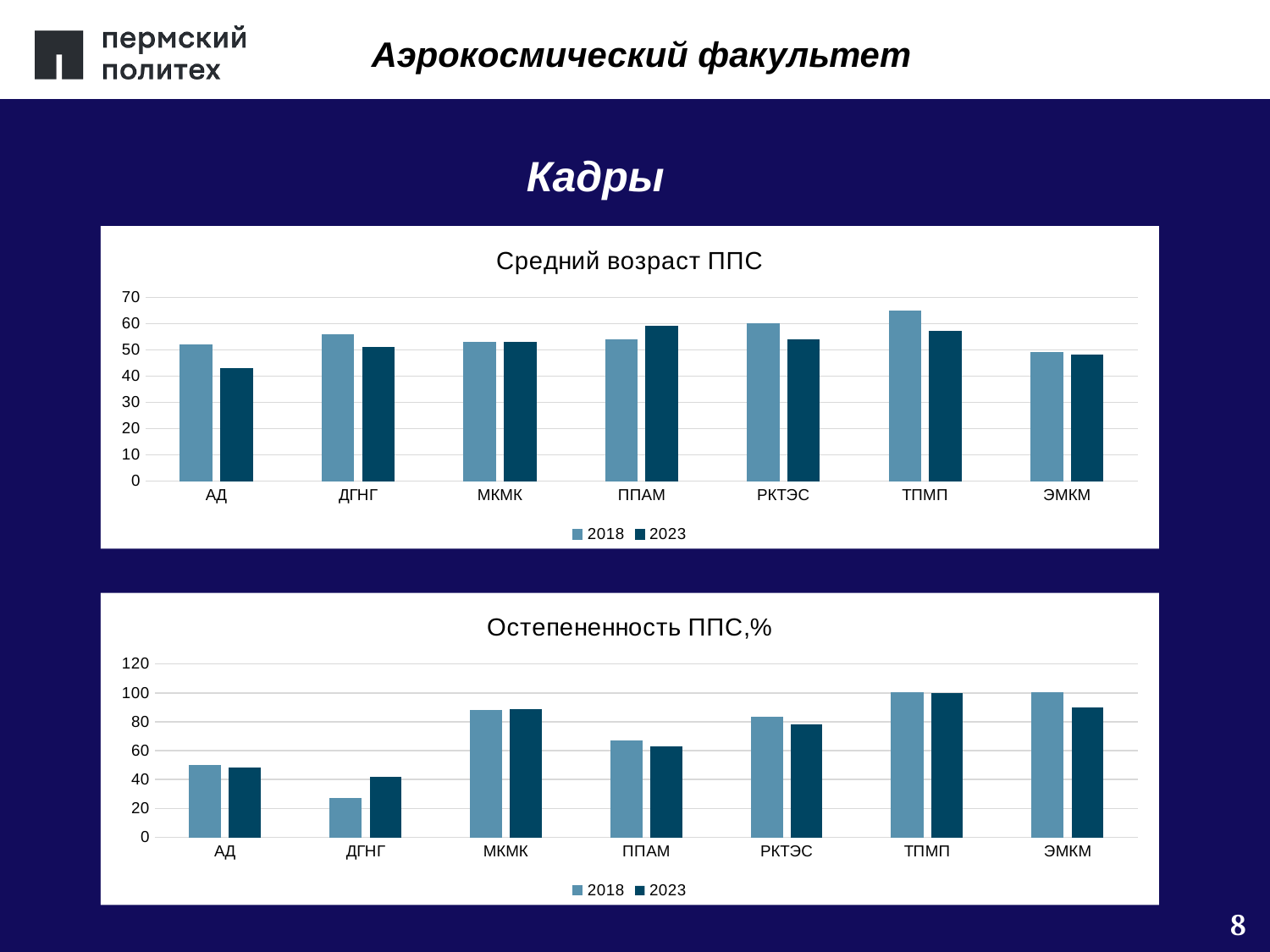
How many categories are shown on the x axis of the "Средний возраст ППС" chart? 7 What kind of chart is the "Средний возраст ППС" chart? bar chart In the "Средний возраст ППС" chart, is the 2023 value for АД greater or less than 50? less What is the title of the bottom chart on the slide? Остепененность ППС,% In the "Средний возраст ППС" chart, which is larger for ППАМ: the 2018 value or the 2023 value? 2023 In the "Остепененность ППС,%" chart, is the 2023 value for ЭМКМ greater or less than 80? greater In the "Остепененность ППС,%" chart, which is larger for ДГНГ: the 2018 value or the 2023 value? 2023 In the "Остепененность ППС,%" chart, is the 2018 value for ДГНГ greater or less than 40? less How many series does the legend of the "Средний возраст ППС" chart list? 2 In the "Средний возраст ППС" chart, which category has the lowest value for 2023? АД In the "Остепененность ППС,%" chart, which category has the lowest value for 2018? ДГНГ In the "Средний возраст ППС" chart, which category has the highest value for 2018? ТПМП